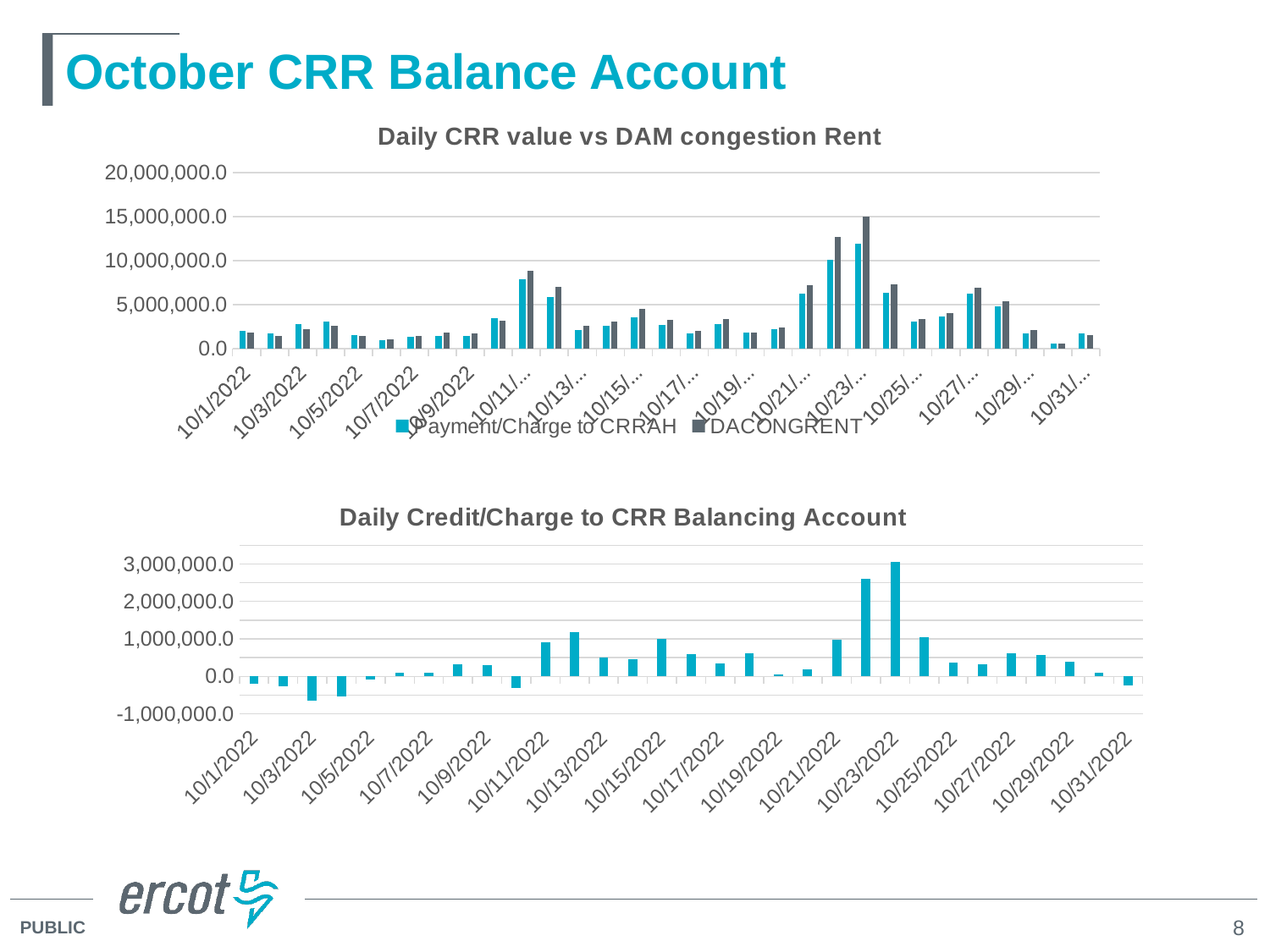
In the top chart, which series has the tallest bar? DACONGRENT In the bottom chart, which is larger: the value for 10/23/2022 or the value for 10/1/2022? 10/23/2022 What is the highest value shown on the y axis of the top chart? 20,000,000.0 In the bottom chart, is the value for 10/1/2022 greater or less than 0? less In the bottom chart, is the value for 10/23/2022 greater or less than 2,000,000? greater What kind of chart is the top chart, 'Daily CRR value vs DAM congestion Rent'? Bar chart What are the two series named in the legend of the top chart? Payment/Charge to CRRAH and DACONGRENT In the bottom chart, do the values rise or fall from 10/21/2022 to 10/23/2022? Rise What kind of chart is the bottom chart, 'Daily Credit/Charge to CRR Balancing Account'? Bar chart In the bottom chart, which date has the highest value? 10/23/2022 In the top chart, is the Payment/Charge to CRRAH value for 10/1/2022 greater or less than 5,000,000? less How many series does the legend of the top chart list? 2